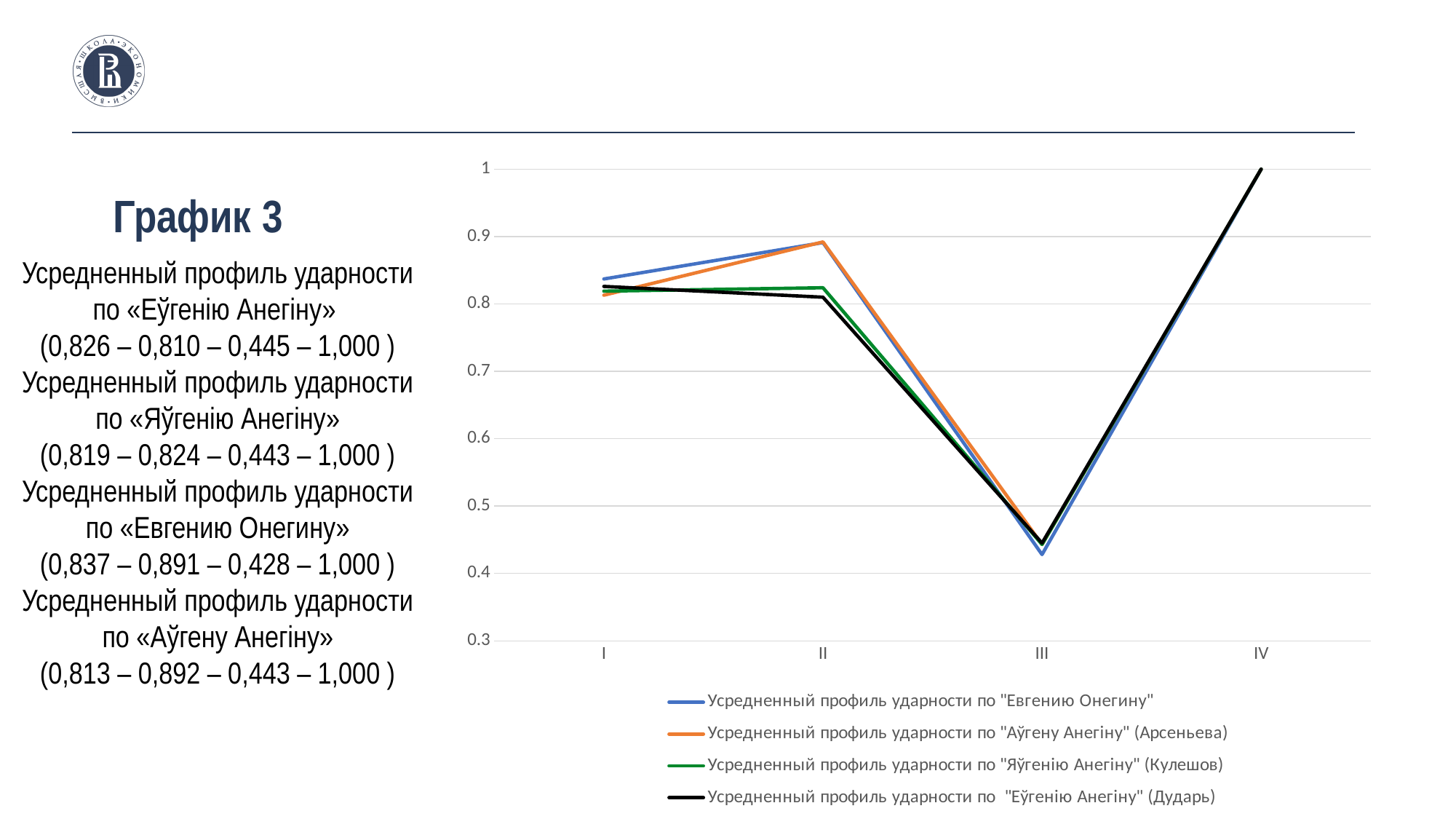
What kind of chart is shown on the slide? line chart How many positions are marked on the x axis? 4 At which x-axis position do all four series reach their highest value? IV Which is larger at position II: the value for "Усредненный профиль ударности по «Евгению Онегину»" or for "Усредненный профиль ударности по «Еўгенію Анегіну»" (Дударь)? Усредненный профиль ударности по «Евгению Онегину» What is the value at position II for the series "Усредненный профиль ударности по «Аўгену Анегіну»" (Арсеньева)? 0,892 Is the value at position III for the series "Усредненный профиль ударности по «Яўгенію Анегіну»" (Кулешов) greater or less than 0.5? less What is the value at position III for the series "Усредненный профиль ударности по «Евгению Онегину»"? 0,428 At which x-axis position does the series "Усредненный профиль ударности по «Евгению Онегину»" reach its lowest value? III What colour is the line for the series "Усредненный профиль ударности по «Еўгенію Анегіну»" (Дударь)? black Do the values of the series fall or rise from position II to position III? fall What is the value at position I for the series "Усредненный профиль ударности по «Еўгенію Анегіну»" (Дударь)? 0,826 How many series does the legend list? 4